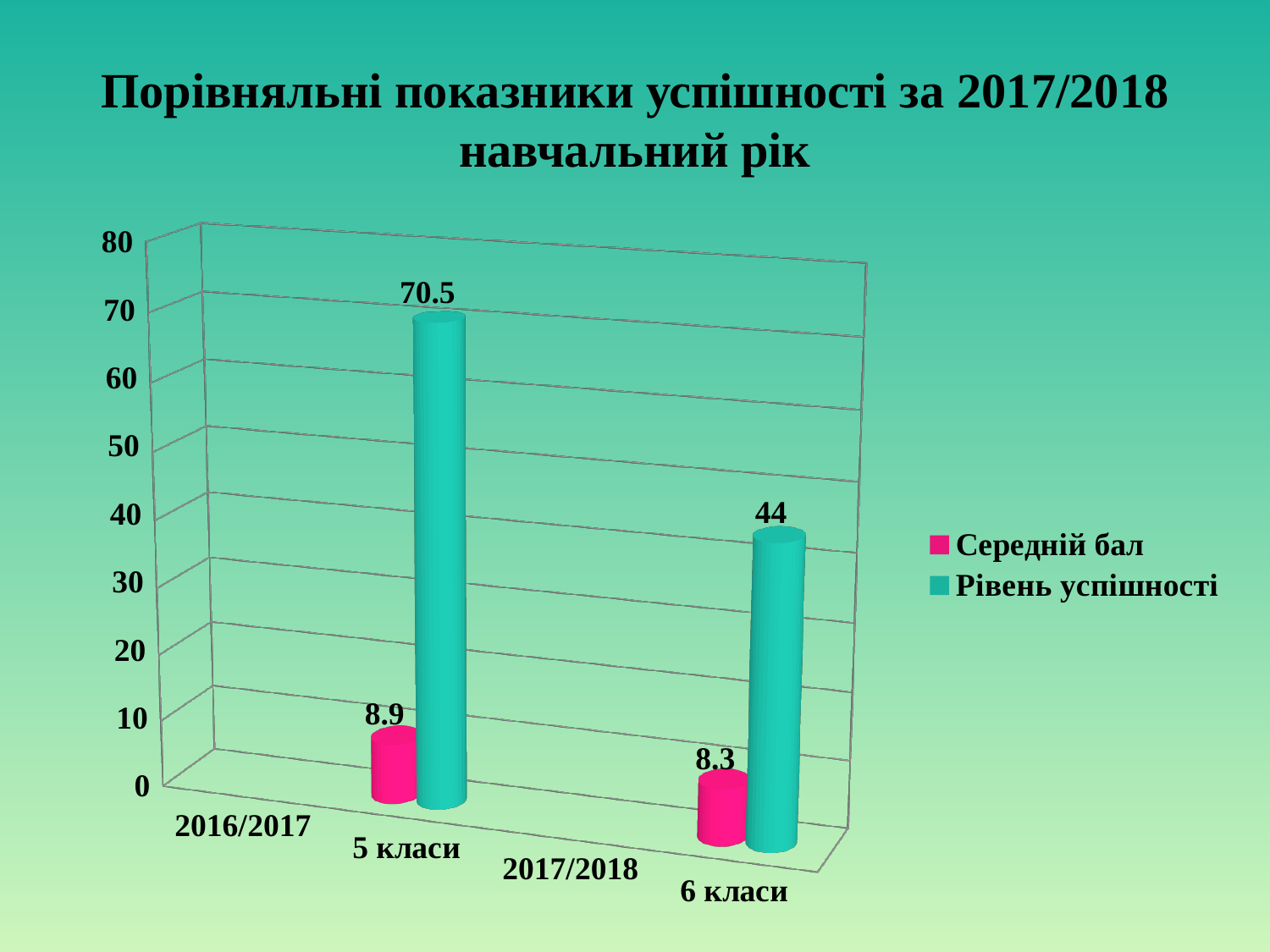
Which category has the lower Середній бал? 2017/2018 6 класи What is the value of Рівень успішності for 2016/2017 5 класи? 70.5 What is the value of Середній бал for 2016/2017 5 класи? 8.9 What kind of chart is shown on the slide? bar chart What is the difference in Рівень успішності between 2016/2017 5 класи and 2017/2018 6 класи? 26.5 Is the Рівень успішності for 2017/2018 6 класи greater or less than 50? less What is the difference in Середній бал between 2016/2017 5 класи and 2017/2018 6 класи? 0.6 How many series does the legend list? 2 Which category has the higher Рівень успішності? 2016/2017 5 класи What is the value of Рівень успішності for 2017/2018 6 класи? 44 Which colour represents Середній бал in the legend? pink What is the value of Середній бал for 2017/2018 6 класи? 8.3